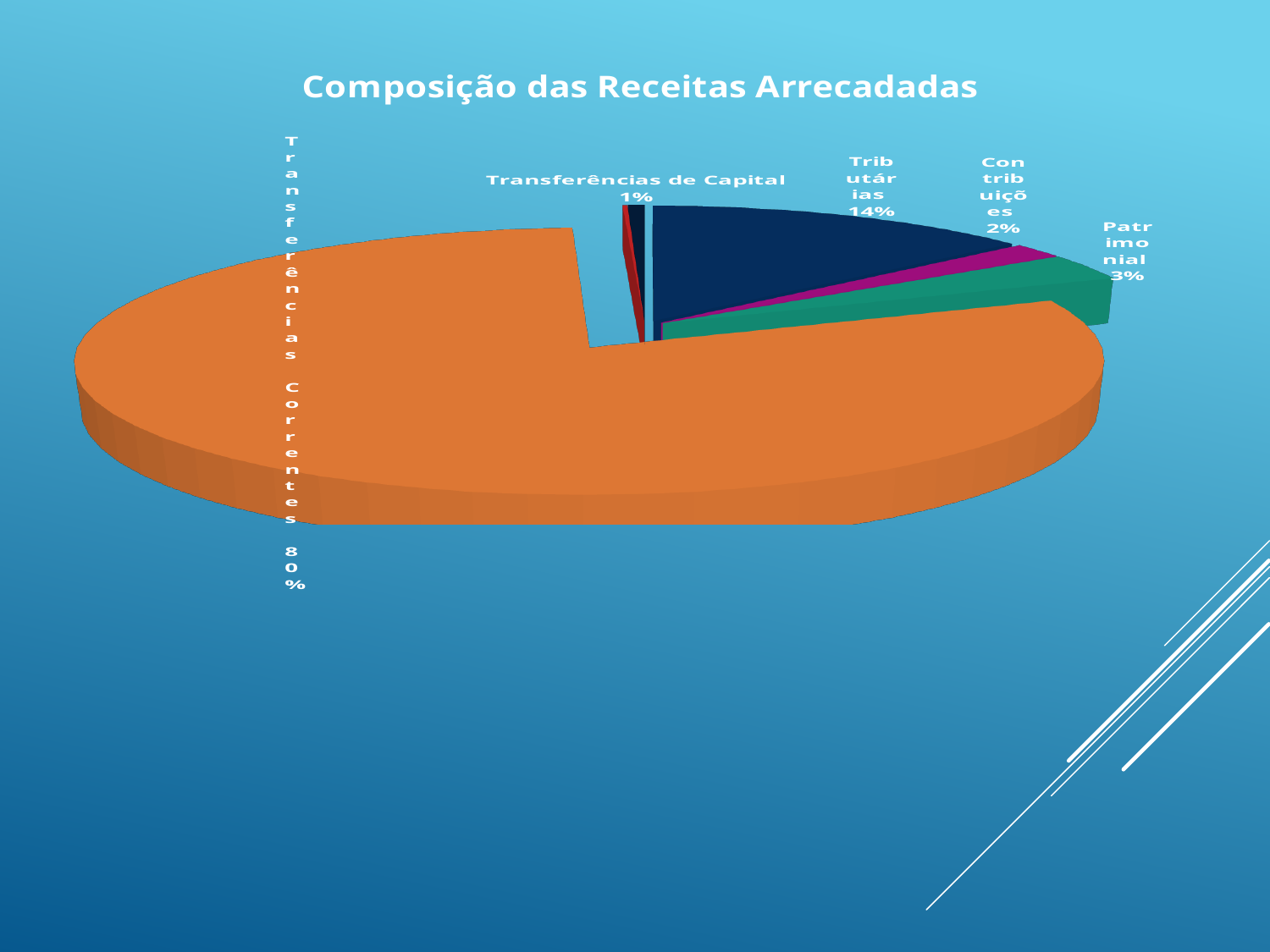
What percentage is shown for Patrimonial? 3% What is the title of the chart? Composição das Receitas Arrecadadas What share of the pie is Transferências Correntes? 80% What is the difference in percentage points between Transferências Correntes and Tributárias? 66 Which labeled category has the smallest share of the pie? Transferências de Capital Which category has the largest share of the pie? Transferências Correntes What percentage is shown for Transferências de Capital? 1% Which is larger, Patrimonial or Contribuições? Patrimonial What is the combined share of Tributárias and Patrimonial? 17% What kind of chart is shown on the slide? pie chart What percentage is shown for Tributárias? 14% What percentage is shown for Contribuições? 2%